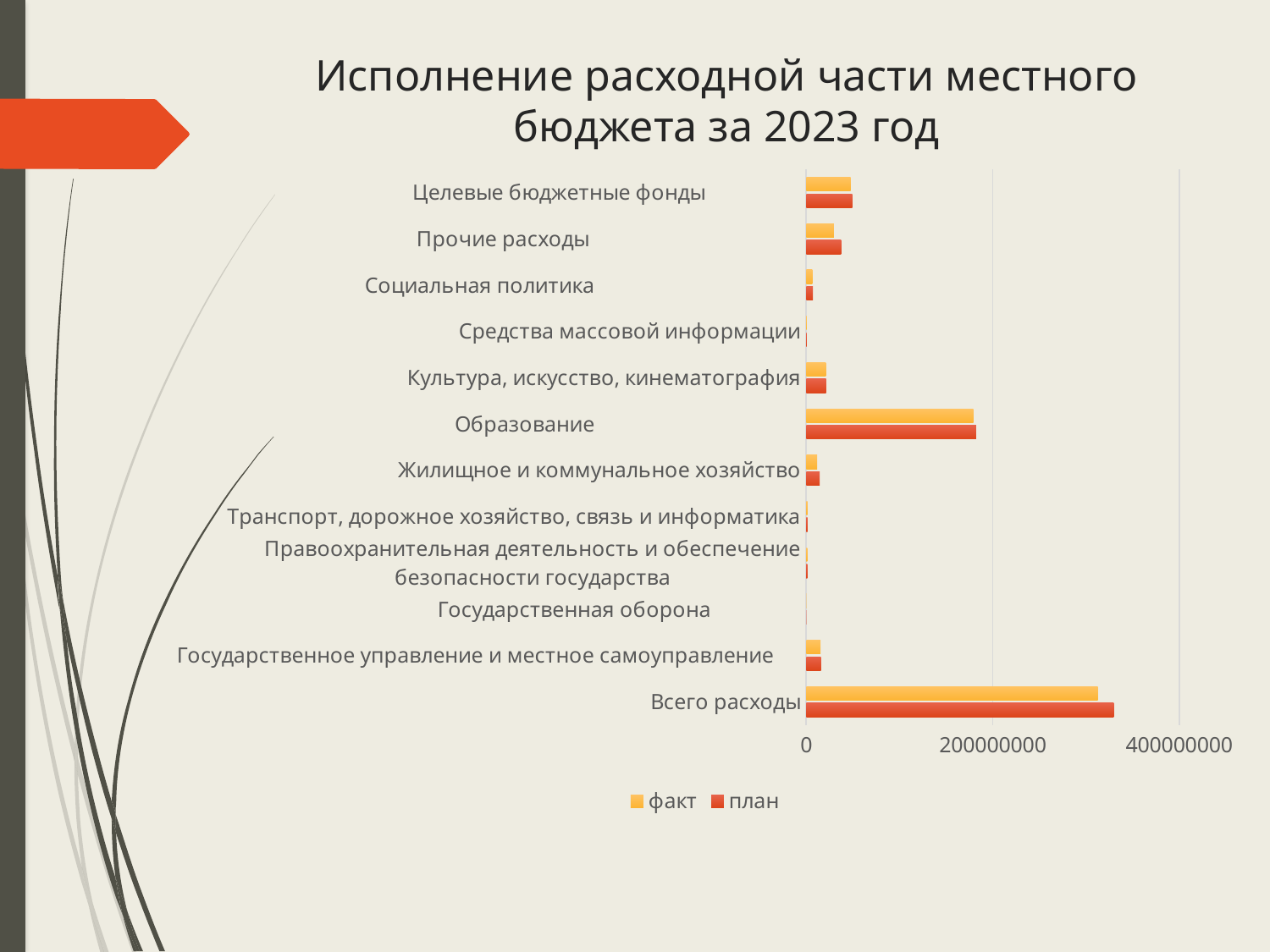
Which is larger for Всего расходы: the план value or the факт value? план What are the two series named in the legend? факт and план Which category has the highest план value? Всего расходы Excluding Всего расходы, which category has the highest факт value? Образование What is the title of the chart on the slide? Исполнение расходной части местного бюджета за 2023 год Is the факт value for Всего расходы greater or less than 200000000? greater Which category has the larger факт value: Образование or Культура, искусство, кинематография? Образование What kind of chart is shown on the slide? bar chart How many series does the legend list? 2 Is the план value for Всего расходы greater or less than 200000000? greater Is the факт value for Образование greater or less than 200000000? less How many categories are shown on the chart? 12